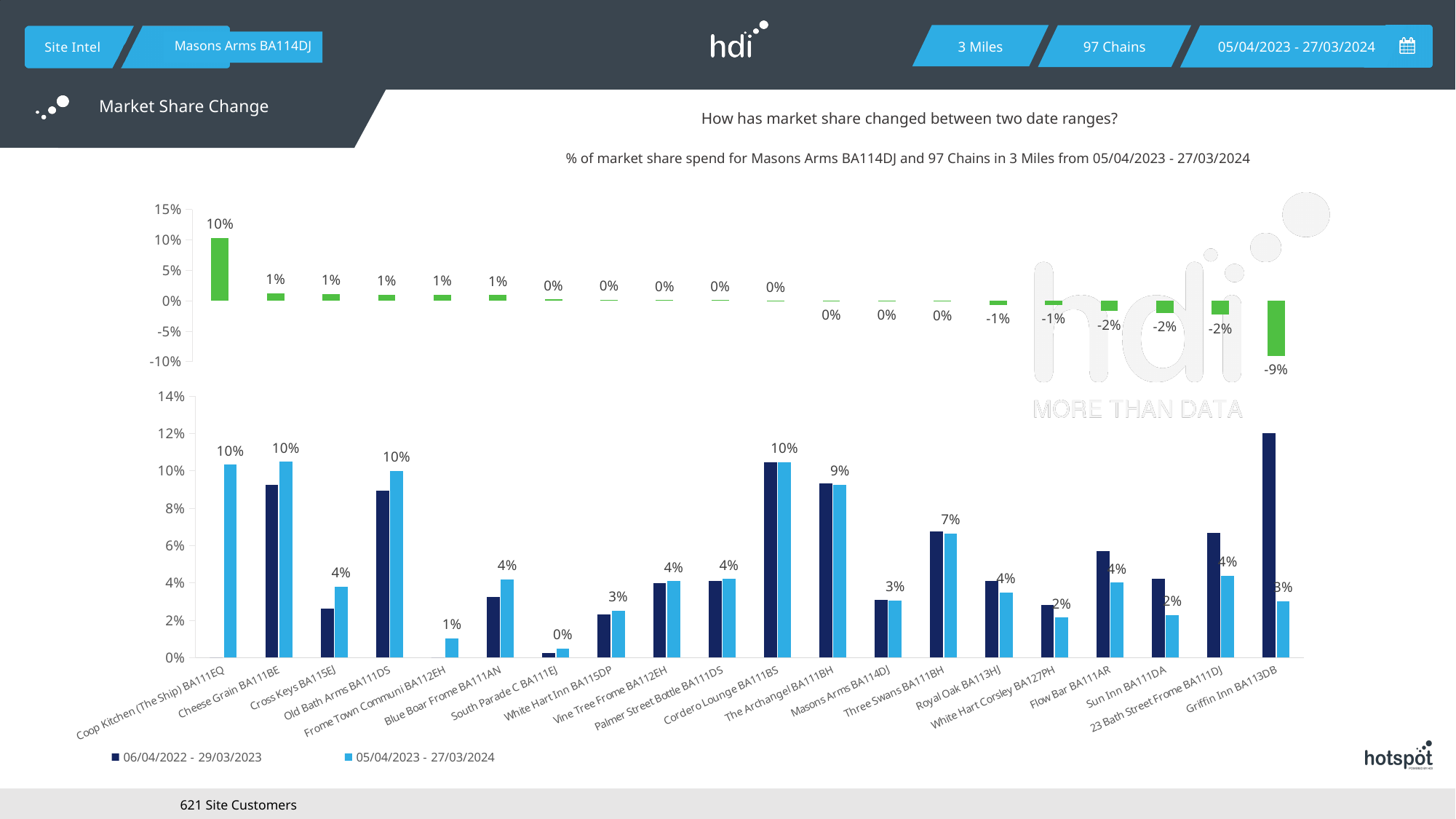
In the top chart (market share change), which category has the highest value? Coop Kitchen (The Ship) BA111EQ In the top chart (market share change), what is the value for Coop Kitchen (The Ship) BA111EQ? 10% In the bottom chart, what is the difference between the 05/04/2023 - 27/03/2024 values for The Archangel BA111BH and Frome Town Communi BA112EH? 8% In the bottom chart, which is larger for the 05/04/2023 - 27/03/2024 series: Cordero Lounge BA111BS or White Hart Corsley BA127PH? Cordero Lounge BA111BS In the bottom chart, what is the value for Three Swans BA111BH in the 05/04/2023 - 27/03/2024 series? 7% In the top chart (market share change), which category has the lowest value? Griffin Inn BA113DB How many series does the legend of the bottom chart list? 2 How many categories are shown on the x axis of the bottom chart? 20 In the bottom chart, is the 06/04/2022 - 29/03/2023 value for Griffin Inn BA113DB greater or less than 10%? greater In the bottom chart, what is the value for Masons Arms BA114DJ in the 05/04/2023 - 27/03/2024 series? 3% In the top chart (market share change), what is the value for Griffin Inn BA113DB? -9% What kind of chart is the bottom chart? Bar chart